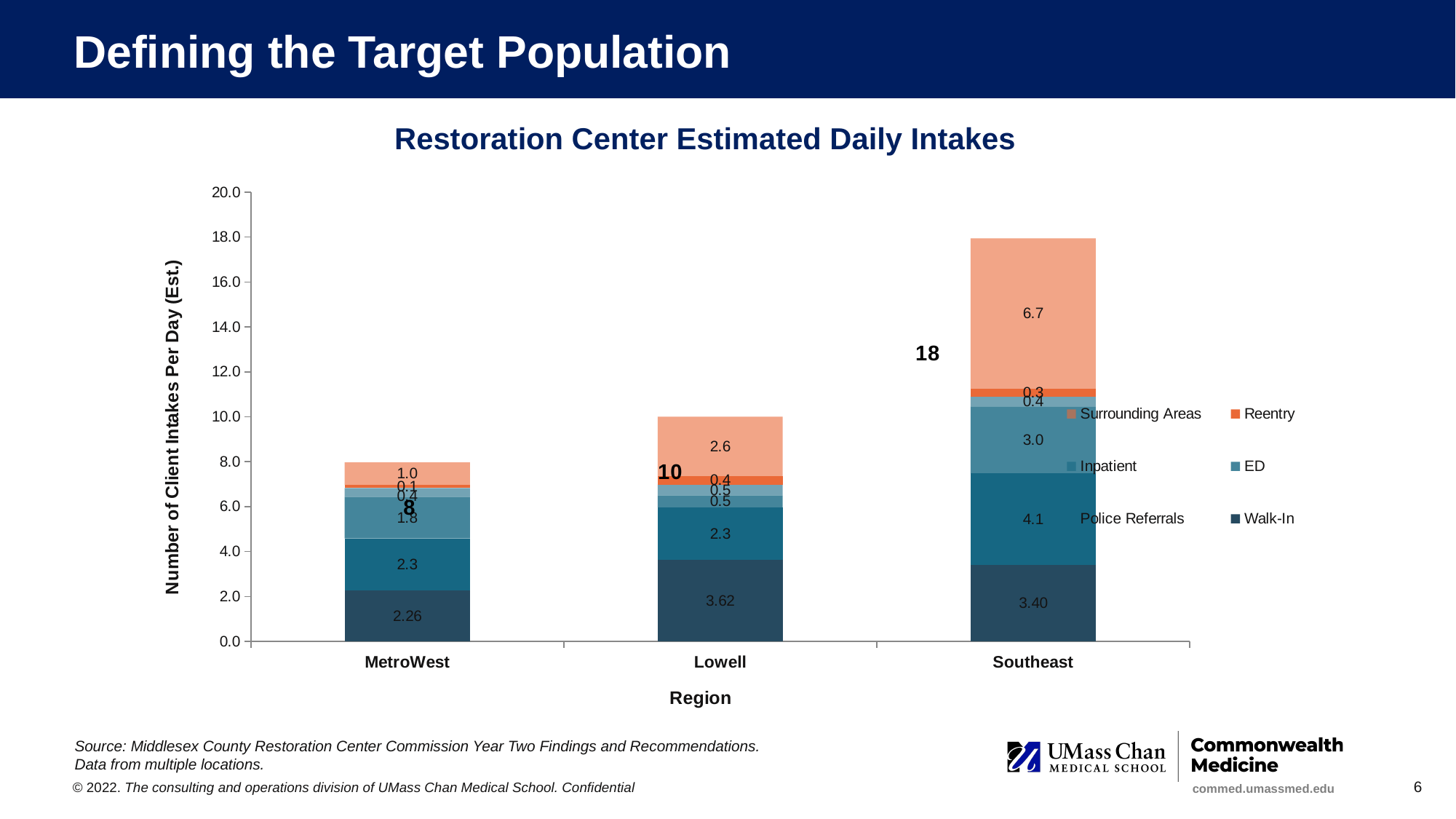
What is the Walk-In value for Lowell? 3.62 What is the difference between the Walk-In values for Lowell and MetroWest? 1.36 What is the total estimated daily intake labelled for the Southeast bar? 18 What is the Surrounding Areas value for Southeast? 6.7 What is the Police Referrals value for Southeast? 4.1 What kind of chart is shown on the slide? Stacked bar chart Is the Surrounding Areas value larger for Lowell or for Southeast? Southeast How many series does the legend list? 6 What is the title of the chart? Restoration Center Estimated Daily Intakes How many regions are shown on the x axis? 3 Which region has the highest total estimated daily intakes? Southeast Which region has the lowest total estimated daily intakes? MetroWest